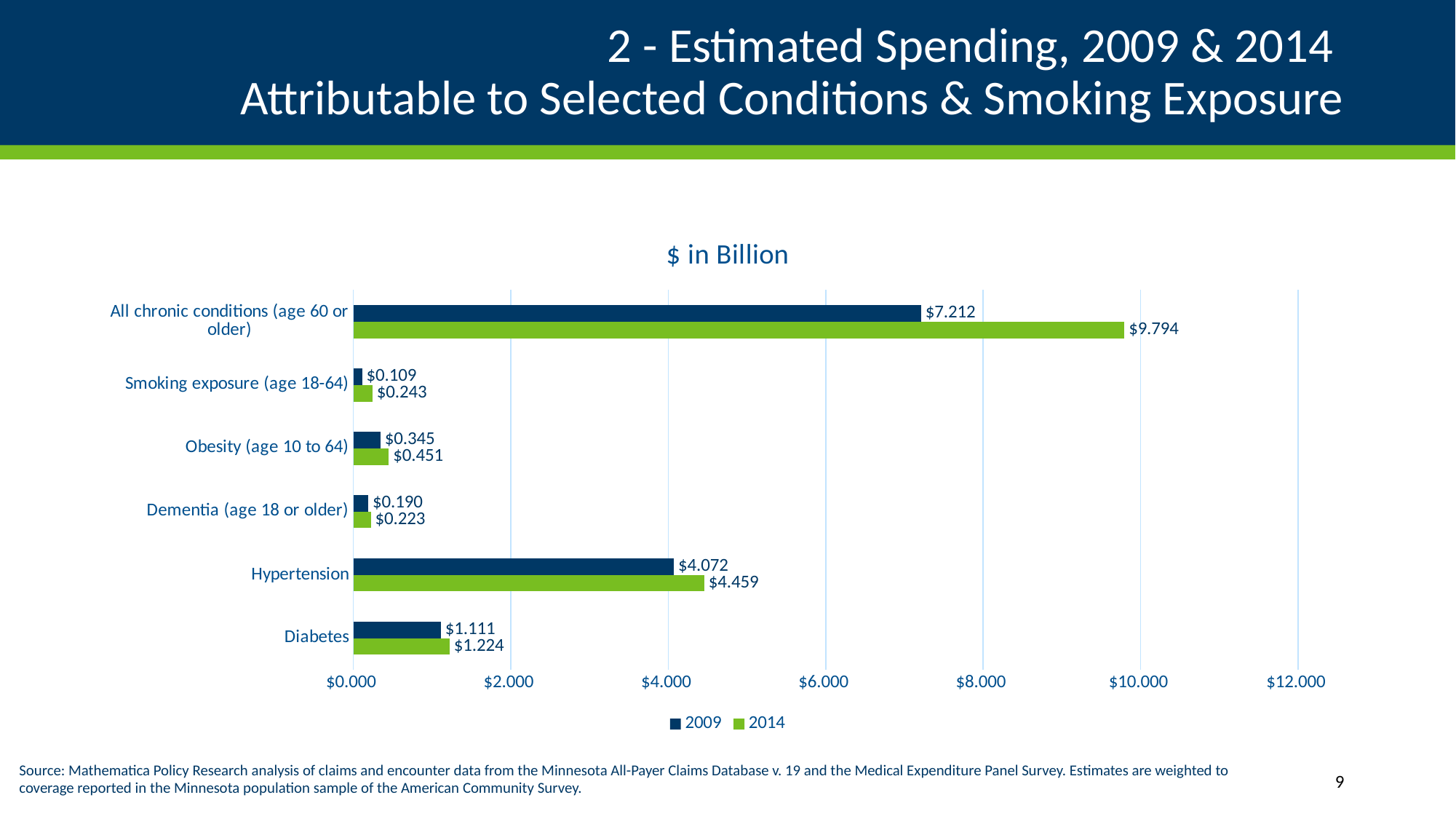
Which is larger: the 2014 value for Obesity (age 10 to 64) or the 2014 value for Dementia (age 18 or older)? Obesity (age 10 to 64) Is the 2014 value for Hypertension greater or less than $4.000? greater What is the difference between the 2014 and 2009 values for All chronic conditions (age 60 or older)? $2.582 How many series does the legend list? 2 Which category has the lowest 2009 value? Smoking exposure (age 18-64) What is the 2014 value for All chronic conditions (age 60 or older)? $9.794 Which category has the highest 2014 value? All chronic conditions (age 60 or older) What is the 2009 value for Diabetes? $1.111 How many categories are shown on the chart? 6 What kind of chart is shown on the slide? bar chart What is the 2009 value for Hypertension? $4.072 What is the 2014 value for Smoking exposure (age 18-64)? $0.243